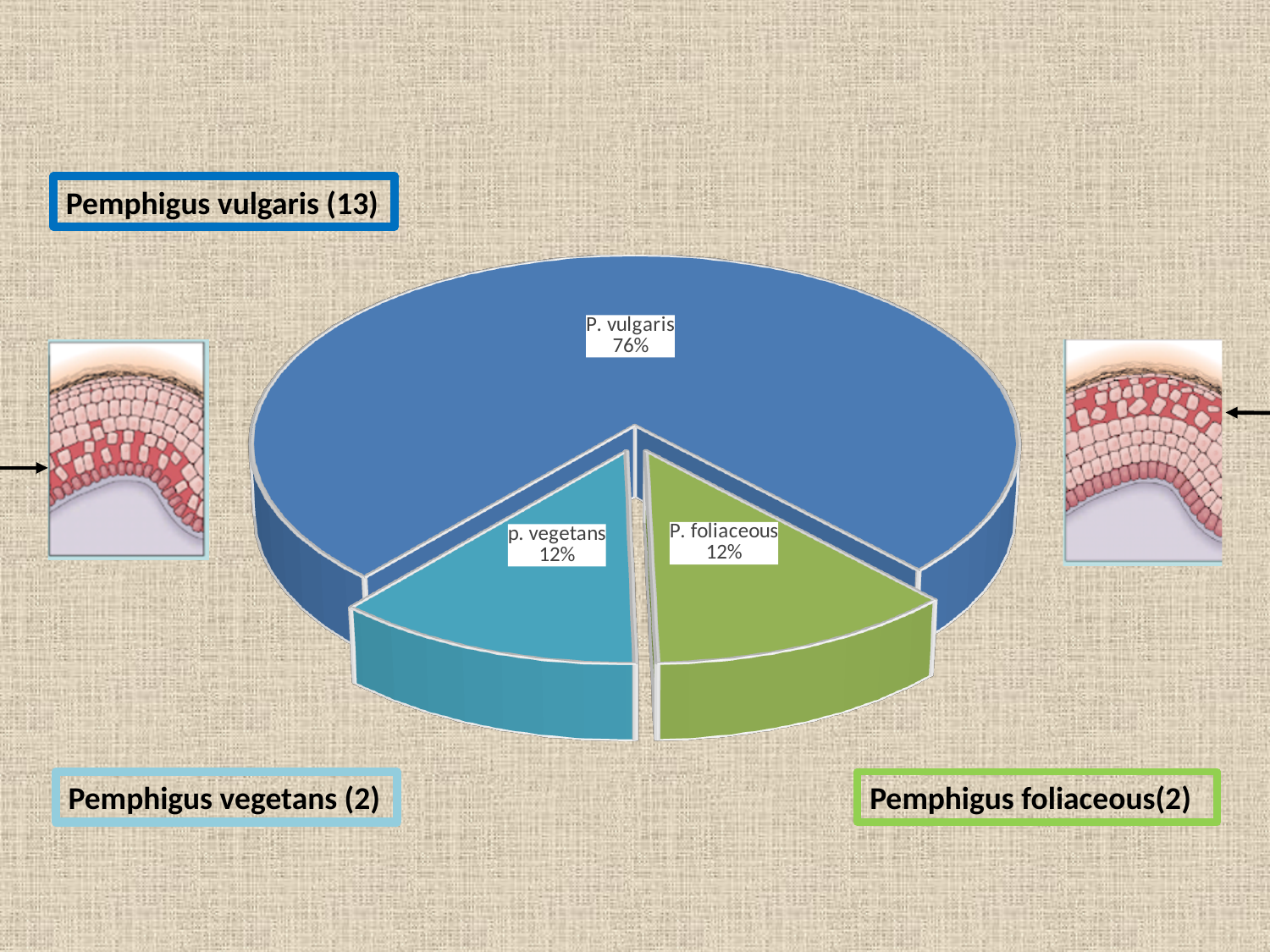
What is the combined share of the p. vegetans and P. foliaceous slices? 24% Is the share for P. vulgaris greater or less than 50%? greater What is the difference in percentage points between the P. vulgaris slice and the p. vegetans slice? 64 What colour is the P. vulgaris slice? Blue What share of the pie does P. foliaceous represent? 12% What kind of chart is shown on the slide? Pie chart Which is larger, the P. vulgaris slice or the P. foliaceous slice? P. vulgaris What share of the pie does p. vegetans represent? 12% What share of the pie does P. vulgaris represent? 76% Which slice of the pie is the largest? P. vulgaris How many slices does the pie chart have? 3 What colour is the P. foliaceous slice? Green